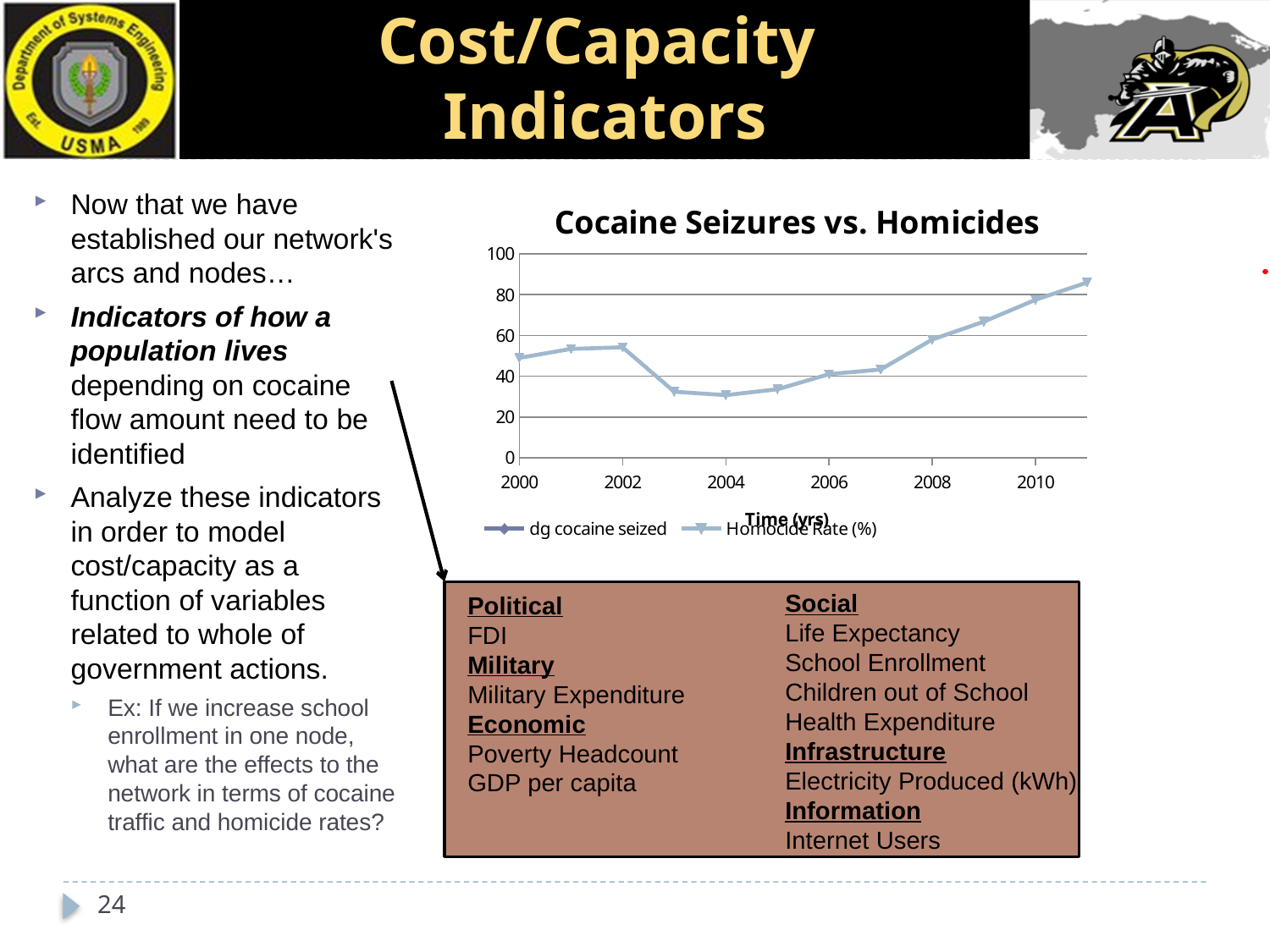
Which year has the larger Homocide Rate (%) value, 2006 or 2008? 2008 Is the Homocide Rate (%) value for 2008 greater or less than 80? less Is the Homocide Rate (%) value for 2000 greater or less than 40? greater Is the Homocide Rate (%) value for 2010 greater or less than 60? greater What kind of chart is shown on the slide? line chart Among the labeled years 2000, 2002, 2004, 2006, 2008 and 2010, which has the lowest Homocide Rate (%) value? 2004 What is the x-axis title of the chart? Time (yrs) Which year has the larger Homocide Rate (%) value, 2002 or 2004? 2002 Does the Homocide Rate (%) line rise or fall between 2004 and 2010? rise How many series does the chart legend list? 2 What is the title of the chart? Cocaine Seizures vs. Homicides